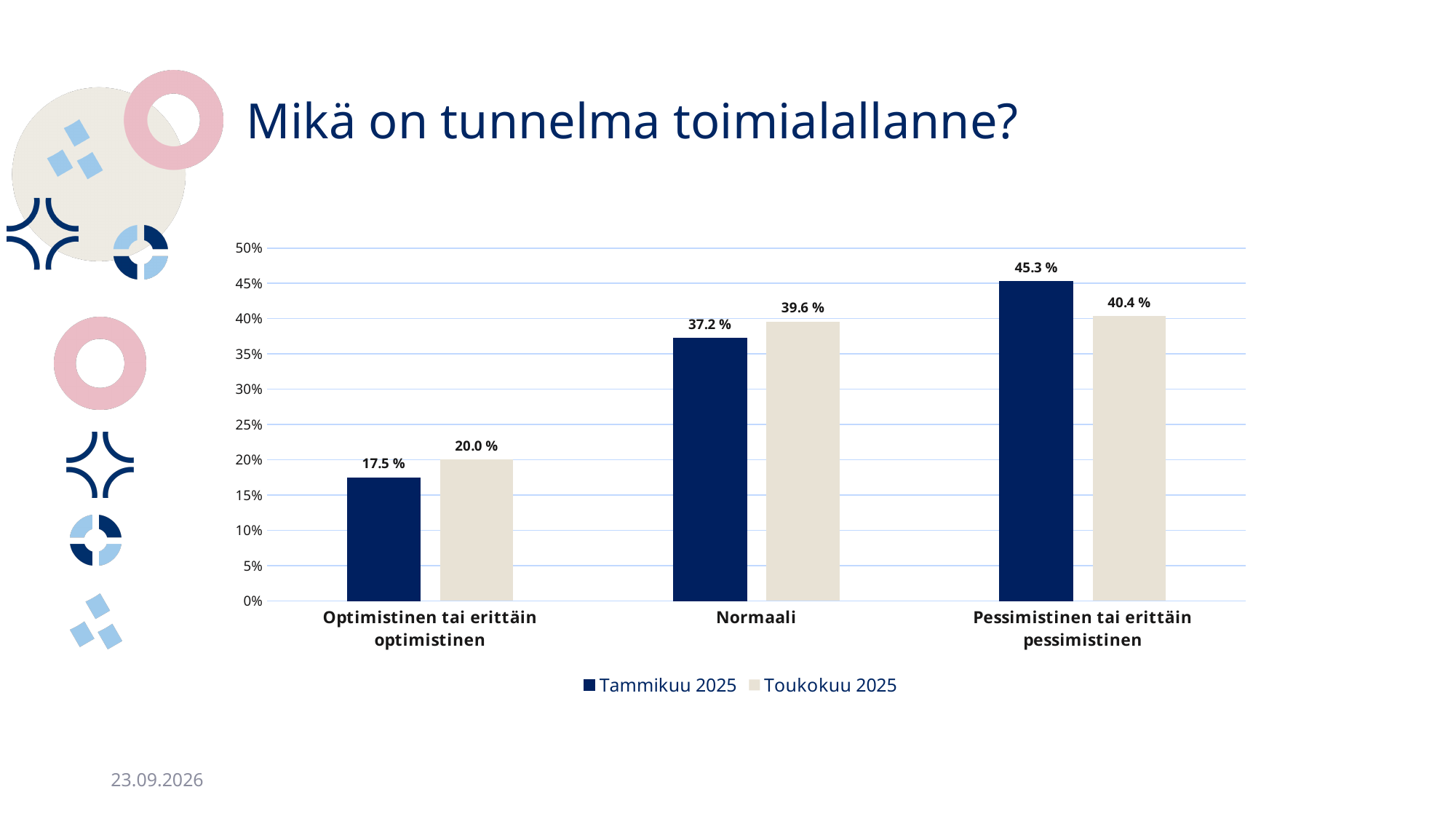
Which category has the lowest value in the Toukokuu 2025 series? Optimistinen tai erittäin optimistinen Which is larger for Normaali: the Tammikuu 2025 value or the Toukokuu 2025 value? Toukokuu 2025 What kind of chart is shown on the slide? bar chart Is the Tammikuu 2025 value for Optimistinen tai erittäin optimistinen greater or less than 20%? less What is the value for Normaali in the Tammikuu 2025 series? 37.2 % What is the value for Optimistinen tai erittäin optimistinen in the Toukokuu 2025 series? 20.0 % What is the difference between the Tammikuu 2025 and Toukokuu 2025 values for Pessimistinen tai erittäin pessimistinen? 4.9 % What is the title of the slide? Mikä on tunnelma toimialallanne? Which category has the highest value in the Tammikuu 2025 series? Pessimistinen tai erittäin pessimistinen How many categories are shown on the x axis? 3 How many series does the legend list? 2 What is the value for Pessimistinen tai erittäin pessimistinen in the Toukokuu 2025 series? 40.4 %